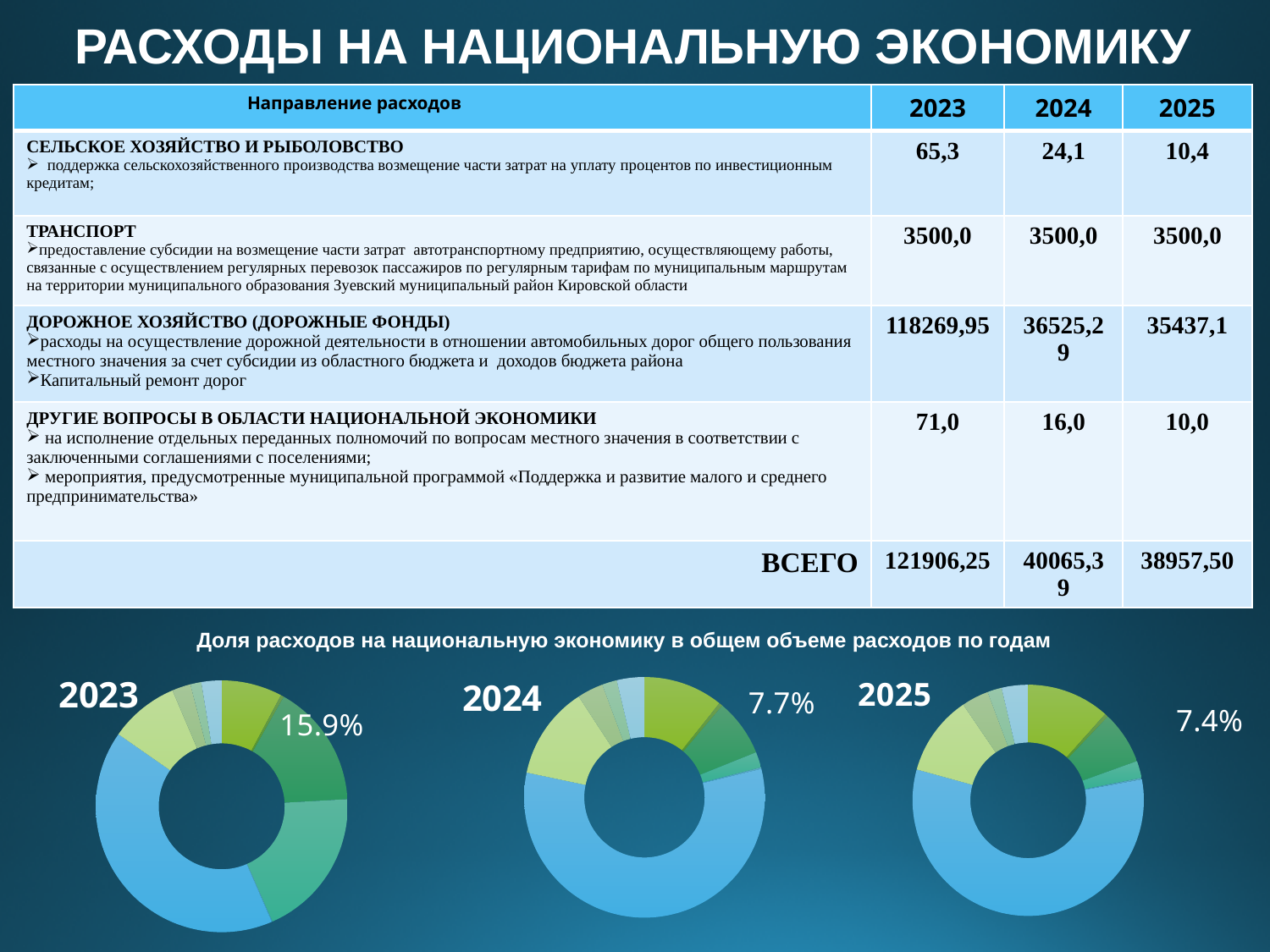
How many donut charts are shown on the slide? 3 Which year's donut chart shows the lowest labelled share of expenses on the national economy? 2025 In the 2023 donut chart, what share is shown by the data label? 15.9% Across the three donut charts, does the labelled share of expenses on the national economy rise or fall from 2023 to 2025? Falls In the 2024 donut chart, what share is shown by the data label? 7.7% What is the title written above the three donut charts? Доля расходов на национальную экономику в общем объеме расходов по годам What kind of charts are shown at the bottom of the slide for 2023, 2024 and 2025? Donut (pie) charts In the 2025 donut chart, what share is shown by the data label? 7.4% Is the labelled share in the 2023 donut chart larger or smaller than the labelled share in the 2024 donut chart? Larger What is the difference between the labelled share in the 2023 donut chart and the labelled share in the 2024 donut chart? 8.2% Which year's donut chart shows the highest labelled share of expenses on the national economy? 2023 What is the difference between the labelled share in the 2024 donut chart and the labelled share in the 2025 donut chart? 0.3%